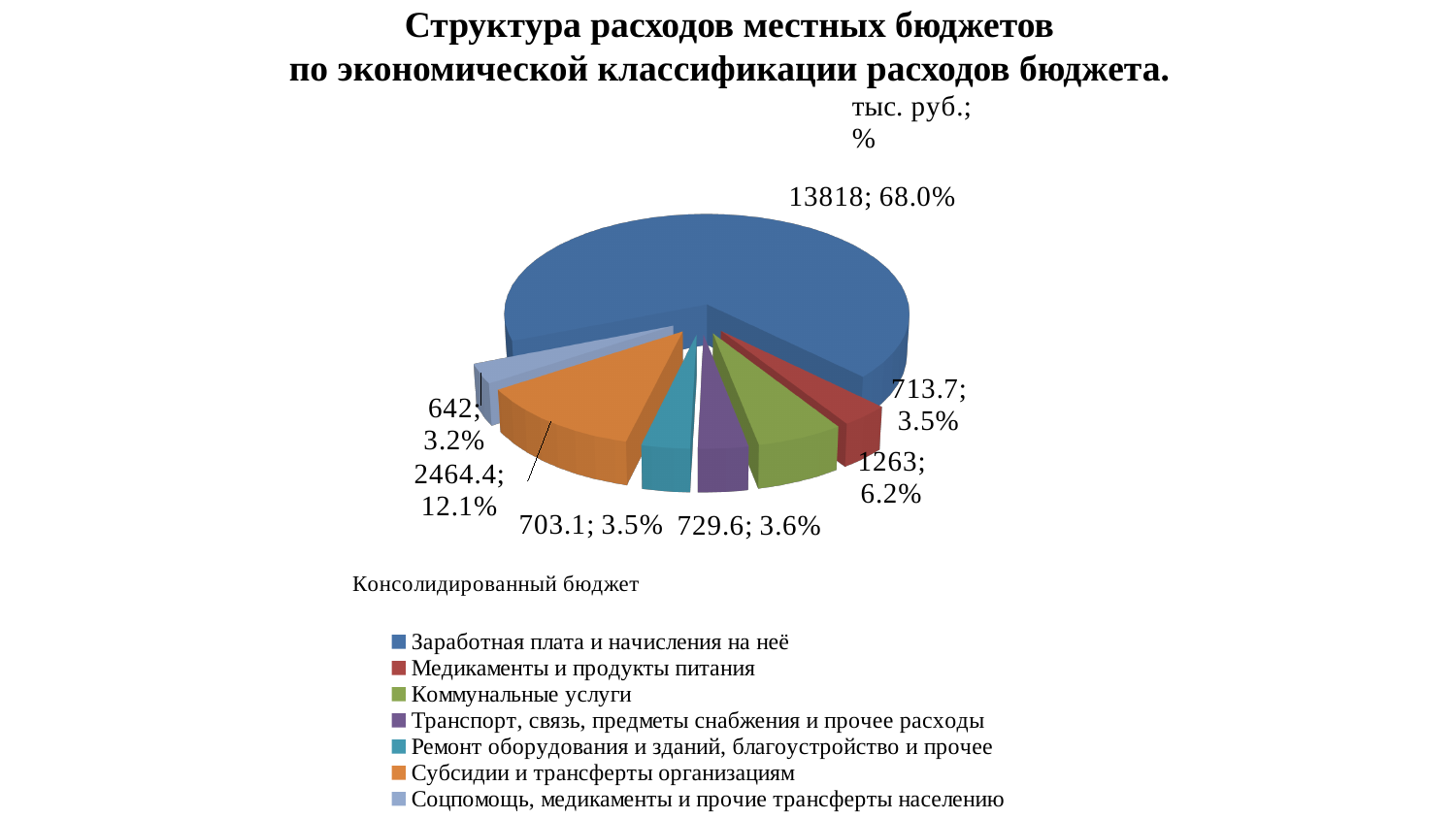
Which category has the largest slice of the pie? Заработная плата и начисления на неё What is the difference between the value for "Субсидии и трансферты организациям" and the value for "Коммунальные услуги"? 1201.4 How many slices does the pie chart have? 7 What kind of chart is shown on the slide? pie chart What value is shown for "Коммунальные услуги"? 1263; 6.2% What label appears directly below the pie chart? Консолидированный бюджет What share of the pie does "Соцпомощь, медикаменты и прочие трансферты населению" represent? 3.2% What share of the pie does "Субсидии и трансферты организациям" represent? 12.1% What value is shown for the slice "Заработная плата и начисления на неё"? 13818; 68.0% How many entries does the legend list? 7 Which category has the smallest slice of the pie? Соцпомощь, медикаменты и прочие трансферты населению Which is larger: the value for "Коммунальные услуги" or the value for "Транспорт, связь, предметы снабжения и прочее расходы"? Коммунальные услуги